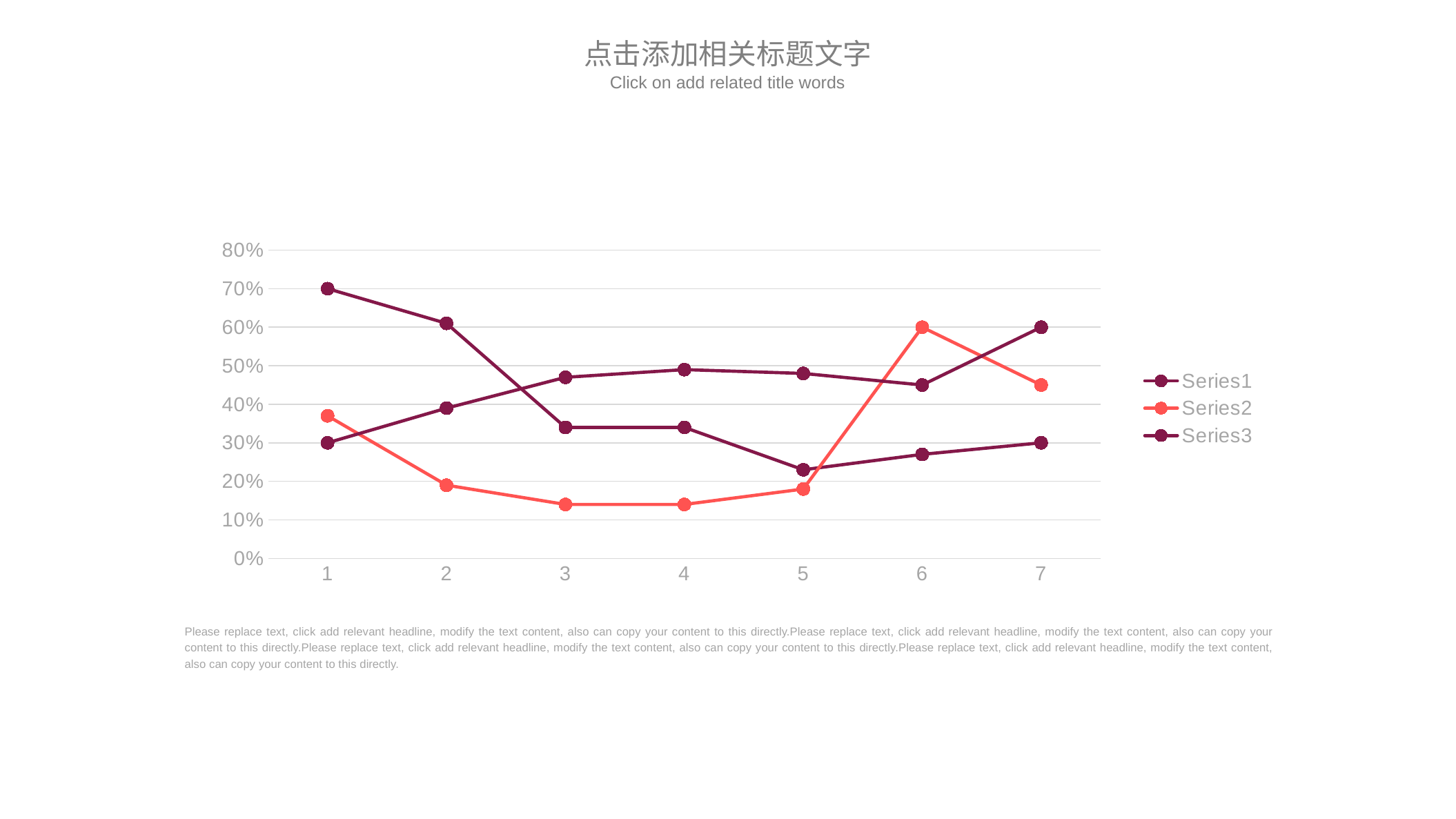
What colour is the Series2 line? orange-red Is the value of Series2 at category 1 greater or less than 30%? greater What is the highest value reached by any line on the chart? 70% At which category does Series2 reach its highest value? 6 What is the value of Series2 at category 6? 60% Which is larger for Series2: the value at category 6 or the value at category 7? category 6 Is the value of Series2 at category 3 greater or less than 20%? less How many categories are shown on the x axis? 7 Is the value of Series2 at category 7 greater or less than 40%? greater How many series does the legend list? 3 Does Series2 rise or fall from category 1 to category 3? fall What kind of chart is shown on the slide? line chart